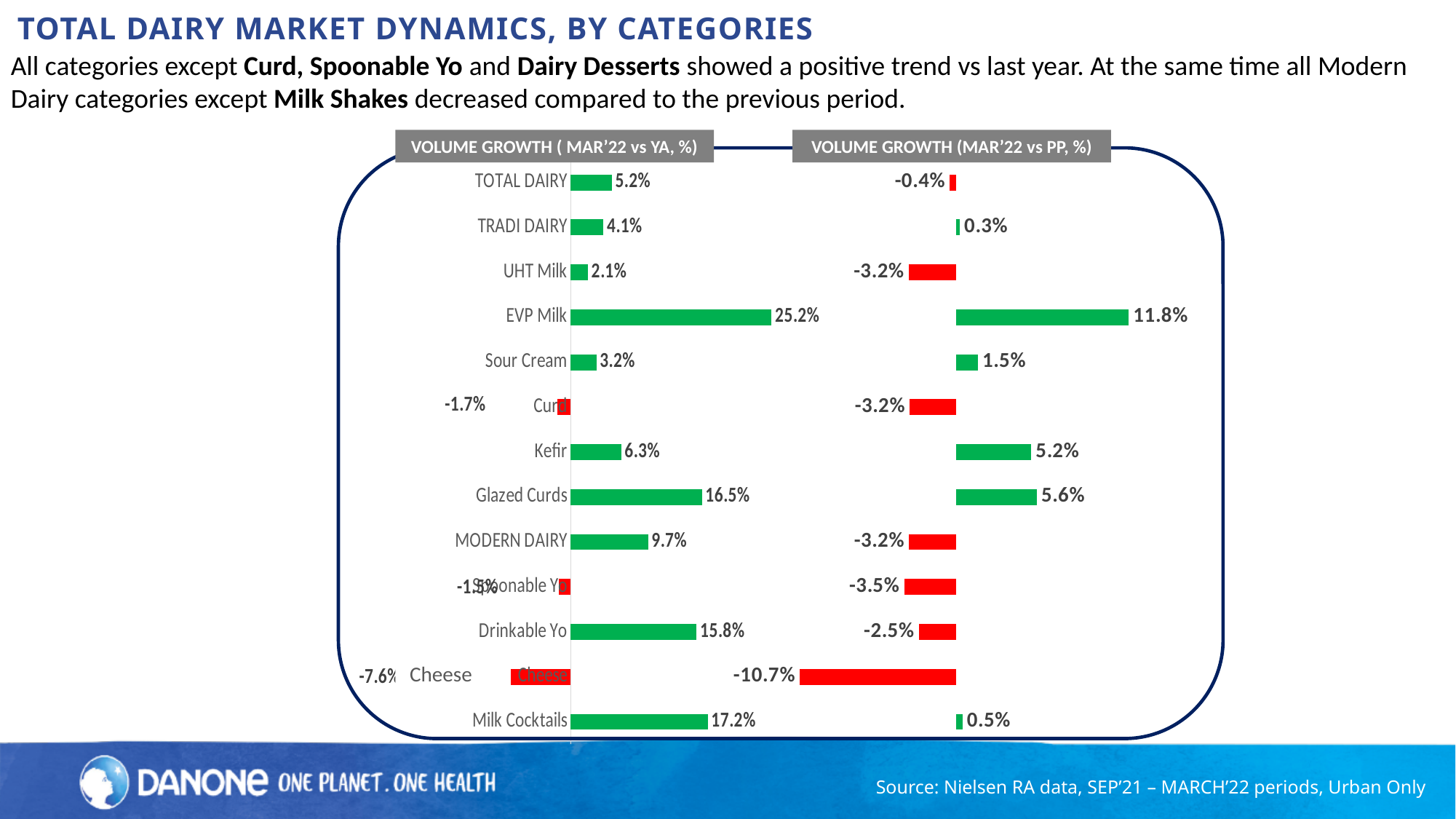
In the VOLUME GROWTH (MAR'22 vs PP, %) chart, which category has the lowest value? Cheese In the VOLUME GROWTH (MAR'22 vs YA, %) chart, what is the value for EVP Milk? 25.2% In the VOLUME GROWTH (MAR'22 vs YA, %) chart, what is the difference between Milk Cocktails and Drinkable Yo? 1.4% What type of chart is the VOLUME GROWTH (MAR'22 vs PP, %) chart? Bar chart In the VOLUME GROWTH (MAR'22 vs PP, %) chart, what is the value for TOTAL DAIRY? -0.4% In the VOLUME GROWTH (MAR'22 vs YA, %) chart, which category has the highest value? EVP Milk How many categories are shown in the VOLUME GROWTH (MAR'22 vs YA, %) chart? 13 In the VOLUME GROWTH (MAR'22 vs PP, %) chart, which is larger, Kefir or Glazed Curds? Glazed Curds In the VOLUME GROWTH (MAR'22 vs YA, %) chart, what is the value for Glazed Curds? 16.5% In the VOLUME GROWTH (MAR'22 vs PP, %) chart, what is the value for Cheese? -10.7% In the VOLUME GROWTH (MAR'22 vs YA, %) chart, what colour are the bars for negative values? Red In the VOLUME GROWTH (MAR'22 vs PP, %) chart, what is the value for MODERN DAIRY? -3.2%